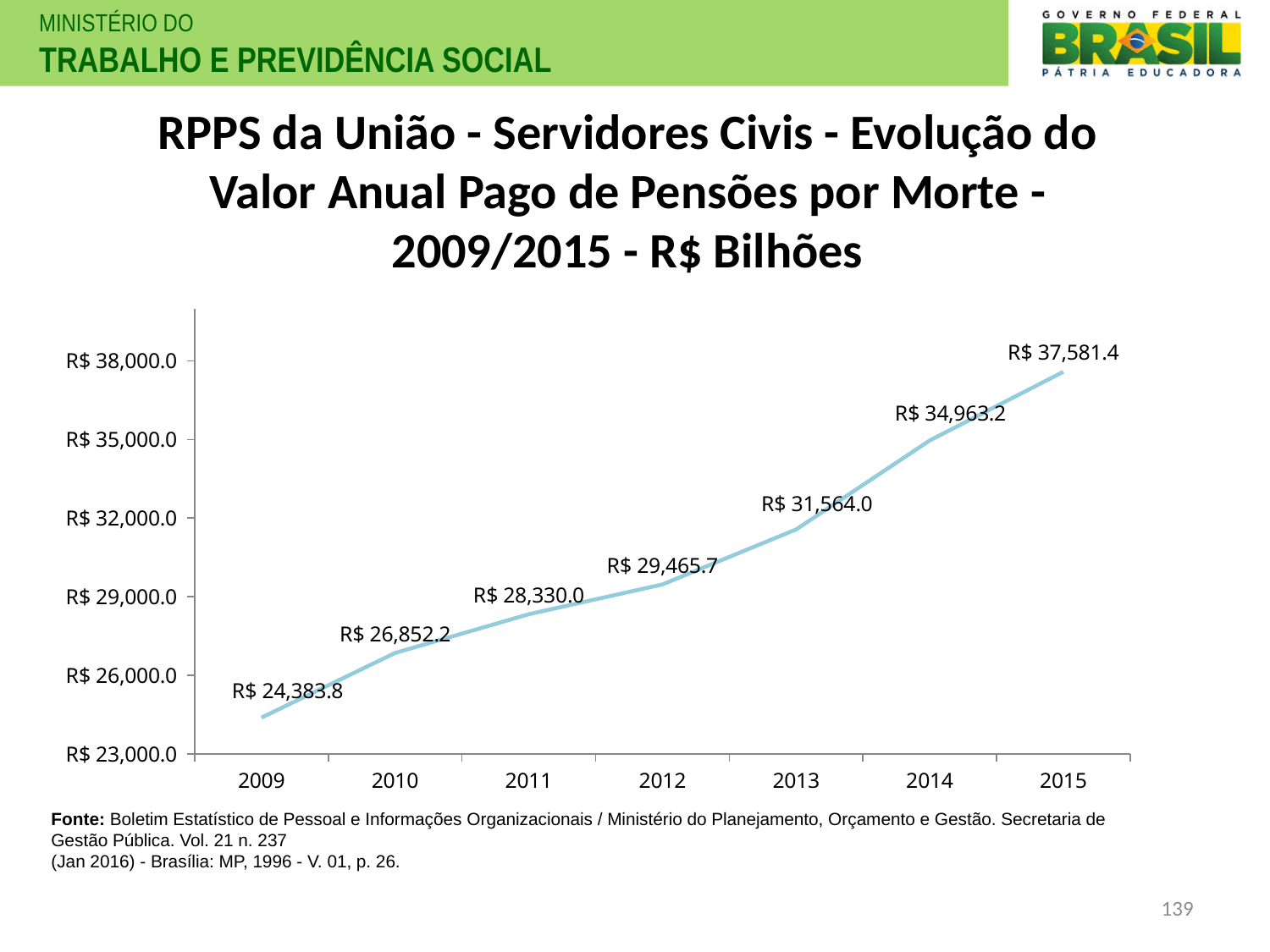
What is the value for 2009? R$ 24,383.8 What is the difference between the values for 2015 and 2009? R$ 13,197.6 What is the value for 2012? R$ 29,465.7 Is the value for 2010 greater or less than R$ 26,000.0? greater What is the value for 2015? R$ 37,581.4 Which is larger, the value for 2011 or the value for 2013? 2013 How many years are plotted on the chart? 7 Which year has the lowest value? 2009 Which year has the highest value? 2015 What is the difference between the values for 2014 and 2013? R$ 3,399.2 What type of chart is shown on the slide? line chart Do the values rise or fall from 2009 to 2015? rise